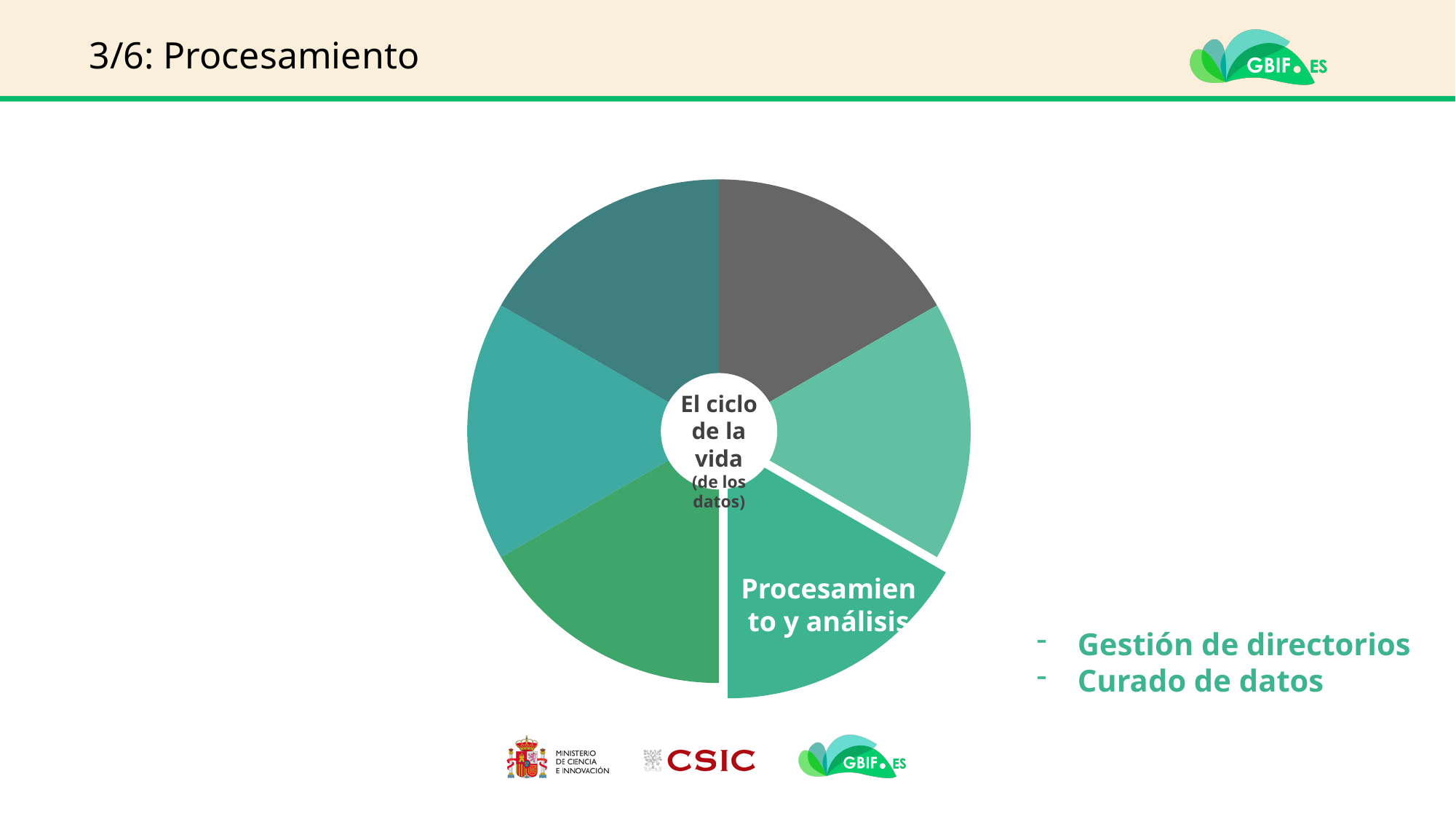
Which slice of the pie chart is pulled out from the rest? Procesamiento y análisis What text appears in the centre of the pie chart? El ciclo de la vida (de los datos) How many slices does the pie chart have? 6 What kind of chart is shown on the slide? Pie chart Which slice of the pie chart is labelled? Procesamiento y análisis How many slices of the pie chart carry a text label? 1